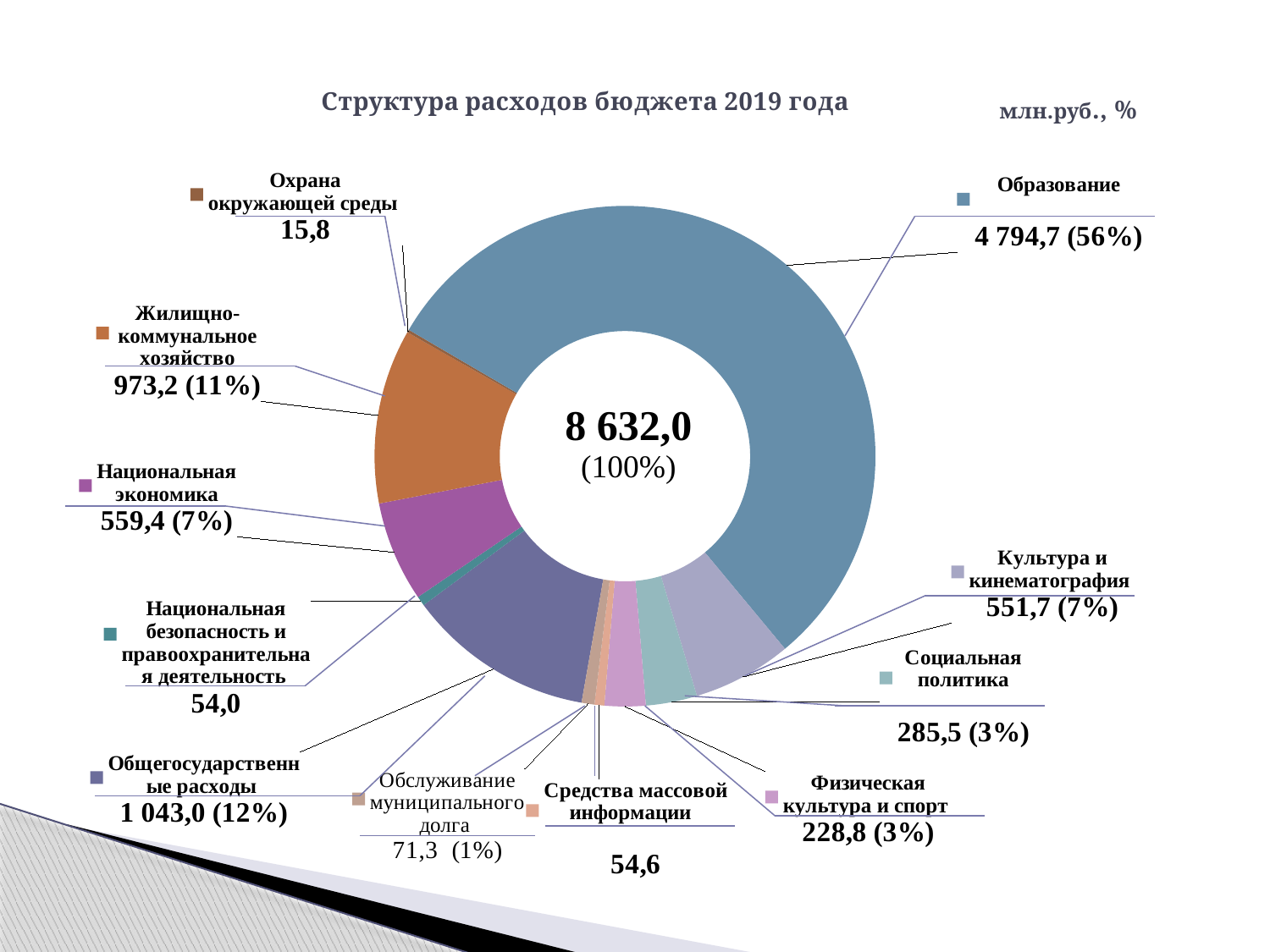
Which is larger, Общегосударственные расходы or Жилищно-коммунальное хозяйство? Общегосударственные расходы What is the value for Жилищно-коммунальное хозяйство? 973,2 What is the value for Охрана окружающей среды? 15,8 Which category has the smallest value? Охрана окружающей среды How many expenditure categories are shown on the chart? 11 Which category has the largest share of expenditure? Образование What is the title of the chart? Структура расходов бюджета 2019 года What is the value for Образование? 4 794,7 What kind of chart is shown on the slide? Doughnut chart What is the total shown in the centre of the chart? 8 632,0 What share of the budget expenditure does Образование account for? 56% What is the difference between Социальная политика and Физическая культура и спорт? 56,7